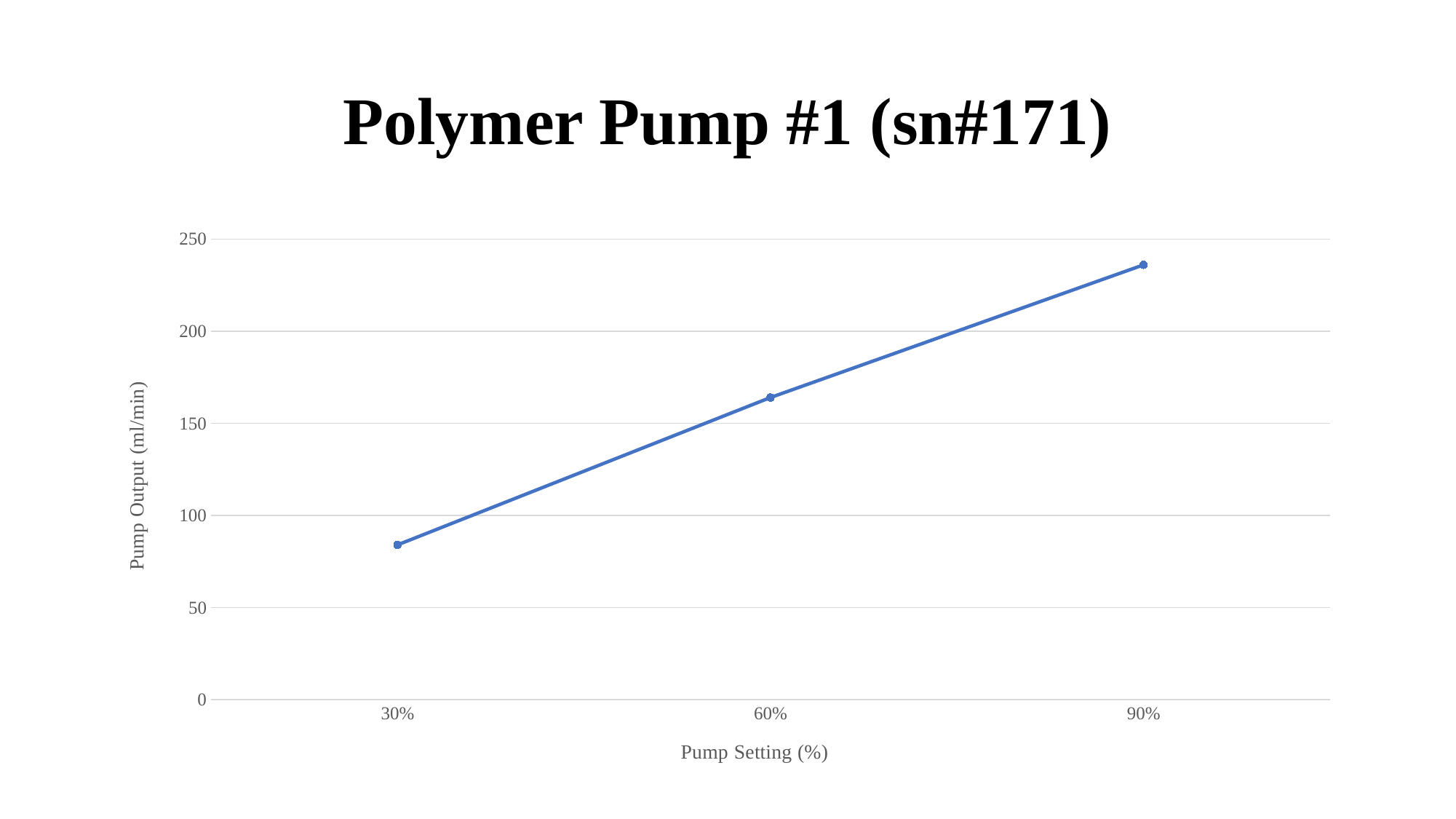
How many pump settings are plotted on the x axis? 3 What kind of chart is shown on the slide? line chart Is the pump output at the 60% setting greater or less than 150? greater Is the pump output at the 30% setting greater or less than 100? less What is the title of the chart? Polymer Pump #1 (sn#171) Does the pump output rise or fall as the pump setting increases from 30% to 90%? rise Which has the larger pump output, the 60% setting or the 30% setting? 60% Which pump setting has the lowest pump output? 30% Which pump setting has the highest pump output? 90% Is the pump output at the 90% setting greater or less than 250? less What is the label of the y axis? Pump Output (ml/min)